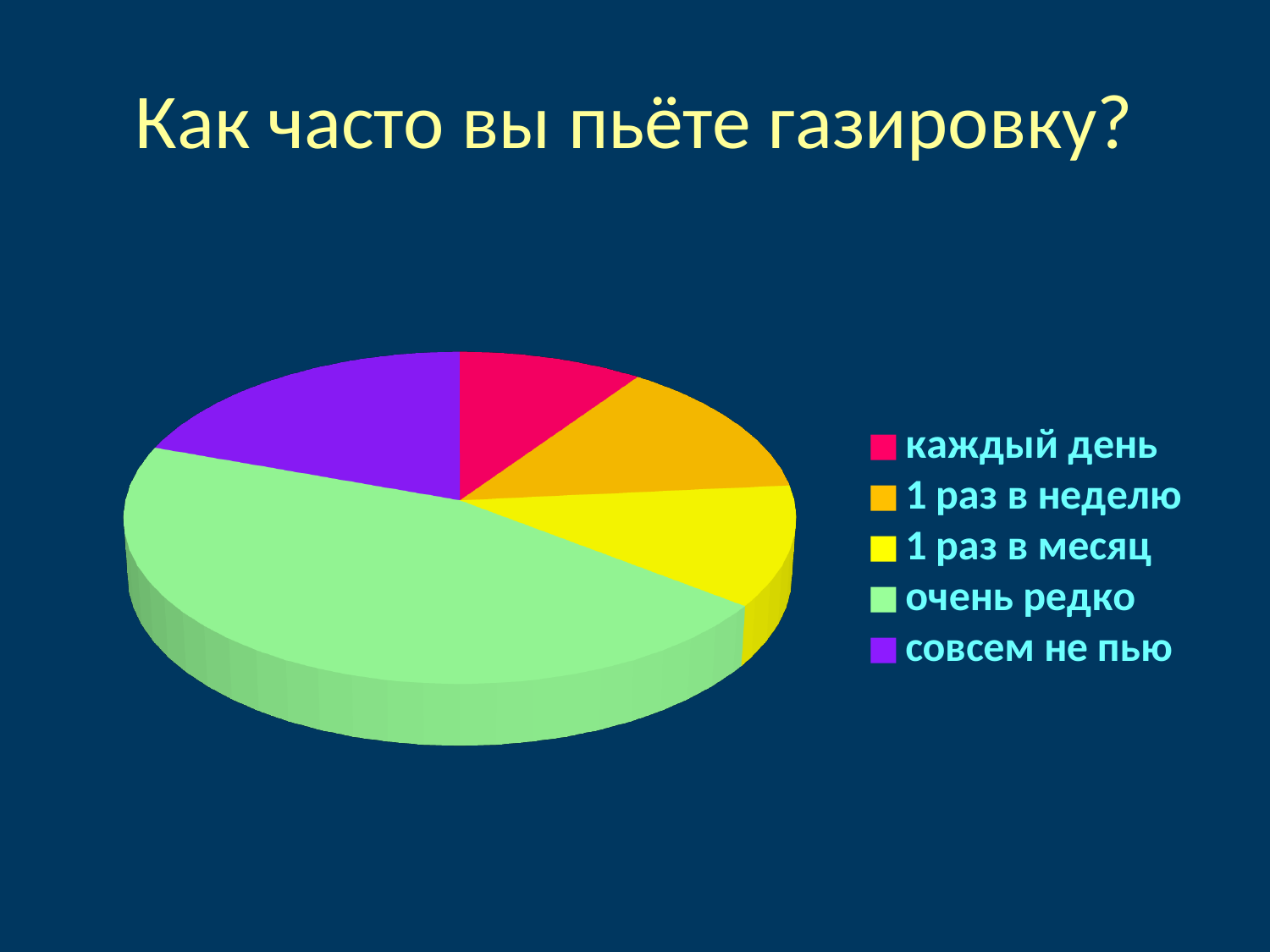
Which category has the largest slice of the pie? очень редко Which slice is larger: "совсем не пью" or "каждый день"? совсем не пью What colour is the slice for "очень редко"? green Which slice is larger: "совсем не пью" or "1 раз в месяц"? совсем не пью Which slice is larger: "очень редко" or "совсем не пью"? очень редко What is the title of the chart on the slide? Как часто вы пьёте газировку? What kind of chart is shown on the slide? pie chart How many categories does the pie chart have? 5